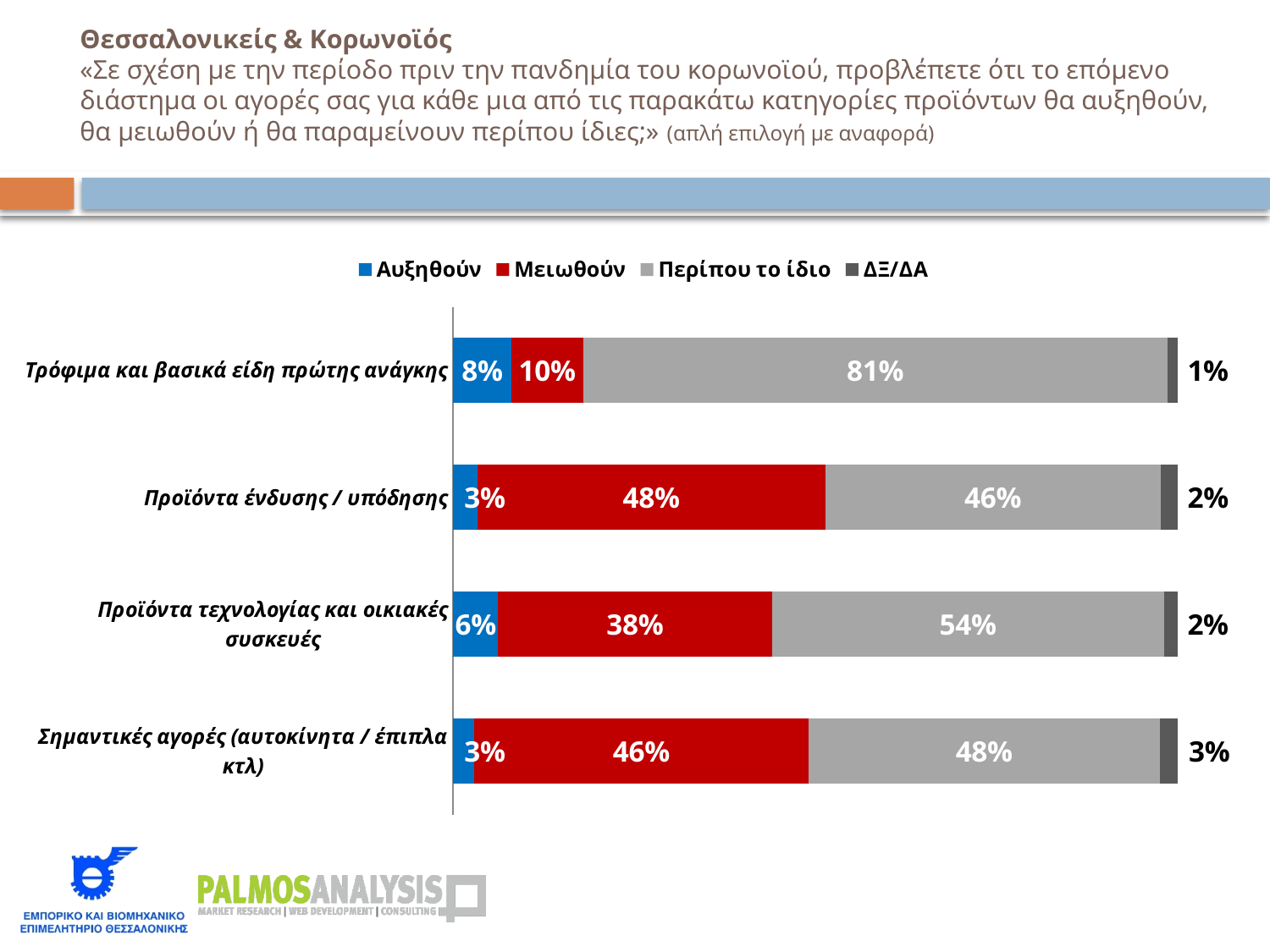
How many product categories are shown in the chart? 4 Which category has the lowest "Περίπου το ίδιο" value? Προϊόντα ένδυσης / υπόδησης How many series does the legend list? 4 What is the value of "Μειωθούν" for "Προϊόντα ένδυσης / υπόδησης"? 48% What kind of chart is shown on the slide? Stacked bar chart What is the value of "Αυξηθούν" for "Προϊόντα τεχνολογίας και οικιακές συσκευές"? 6% Which is larger: the "Αυξηθούν" value for "Τρόφιμα και βασικά είδη πρώτης ανάγκης" or for "Προϊόντα τεχνολογίας και οικιακές συσκευές"? Τρόφιμα και βασικά είδη πρώτης ανάγκης What is the value of "Περίπου το ίδιο" for "Τρόφιμα και βασικά είδη πρώτης ανάγκης"? 81% What is the difference between the "Μειωθούν" values for "Προϊόντα ένδυσης / υπόδησης" and "Τρόφιμα και βασικά είδη πρώτης ανάγκης"? 38% What is the value of "ΔΞ/ΔΑ" for "Σημαντικές αγορές (αυτοκίνητα / έπιπλα κτλ)"? 3% Which category has the highest "Μειωθούν" value? Προϊόντα ένδυσης / υπόδησης Which colour represents the "Μειωθούν" series in the chart? Red